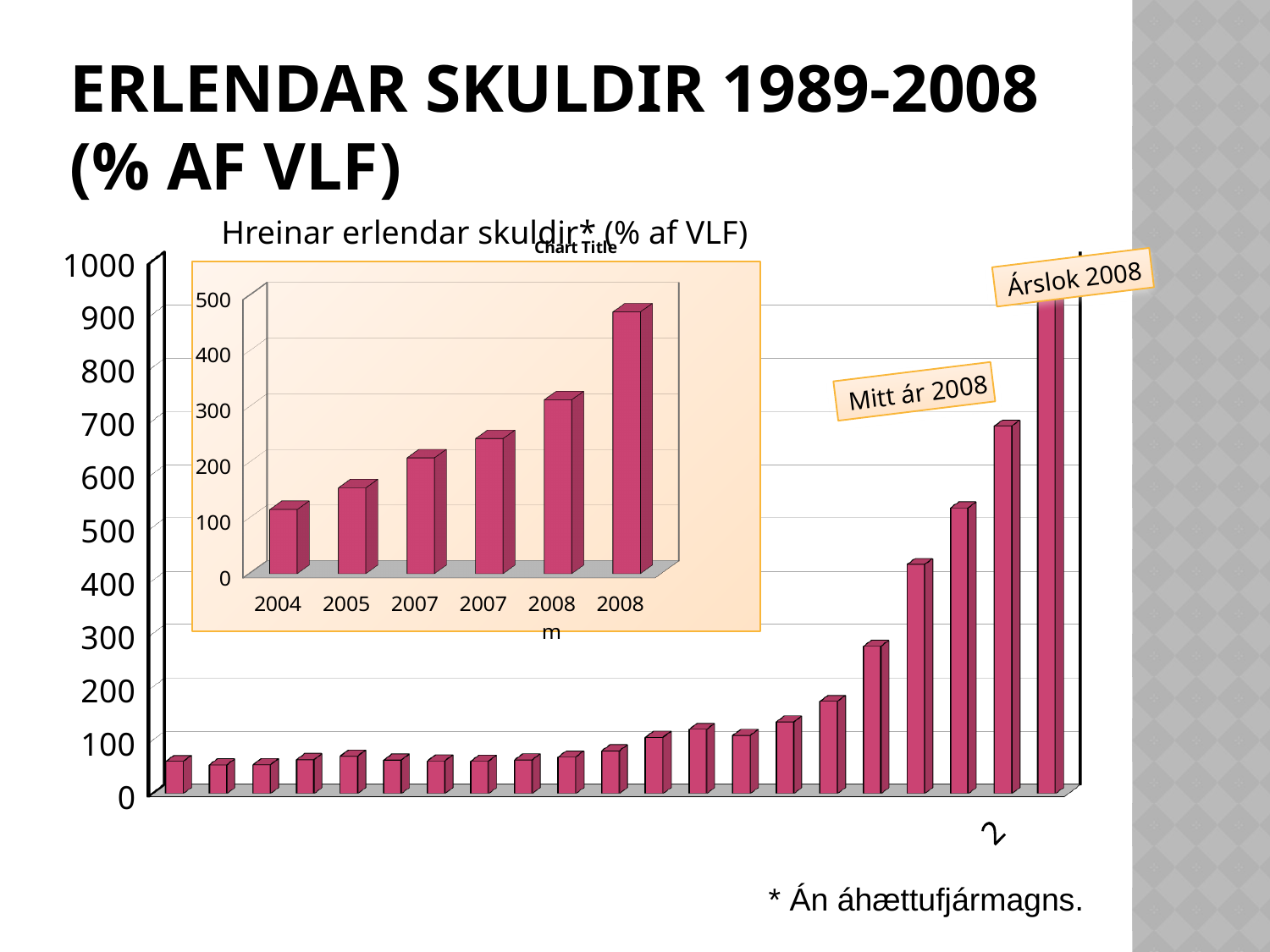
In the inset chart titled "Chart Title", do the values rise or fall from left to right? rise In the inset chart titled "Chart Title", which is larger, the value for 2005 or the value for the first 2008 bar? the first 2008 bar In the inset chart titled "Chart Title", is the value for the rightmost 2008 bar greater or less than 400? greater What is the highest value shown on the vertical axis of the large chart "Hreinar erlendar skuldir* (% af VLF)"? 1000 How many bars does the inset chart titled "Chart Title" show? 6 In the inset chart titled "Chart Title", which category has the tallest bar? the rightmost 2008 bar In the inset chart titled "Chart Title", is the value for 2004 greater or less than 200? less In the large chart "Hreinar erlendar skuldir* (% af VLF)", is the bar labelled "Árslok 2008" greater or less than 900? greater What kind of chart is the inset chart titled "Chart Title"? bar chart In the inset chart titled "Chart Title", which category has the shortest bar? 2004